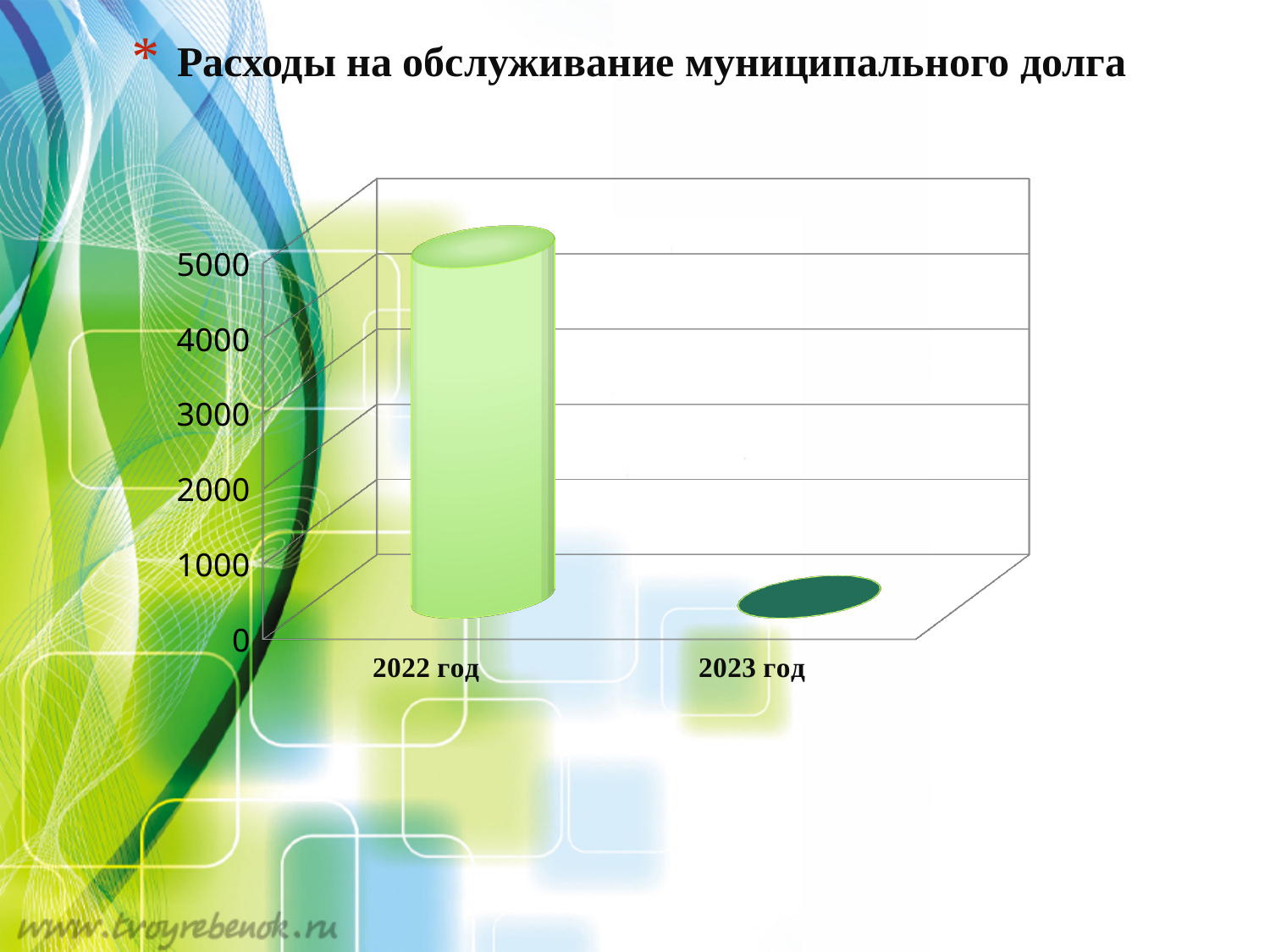
Which is larger, the value for 2022 год or the value for 2023 год? 2022 год Which year has the highest value in the chart? 2022 год Do the values rise or fall from 2022 год to 2023 год? fall How many categories are shown on the x axis of the chart? 2 Is the value for 2023 год greater or less than 1000? less Is the value for 2022 год greater or less than 4000? greater What kind of chart is shown on the slide? bar chart Which year has the lowest value in the chart? 2023 год What is the highest tick value shown on the vertical axis of the chart? 5000 What is the title of the slide above the chart? Расходы на обслуживание муниципального долга